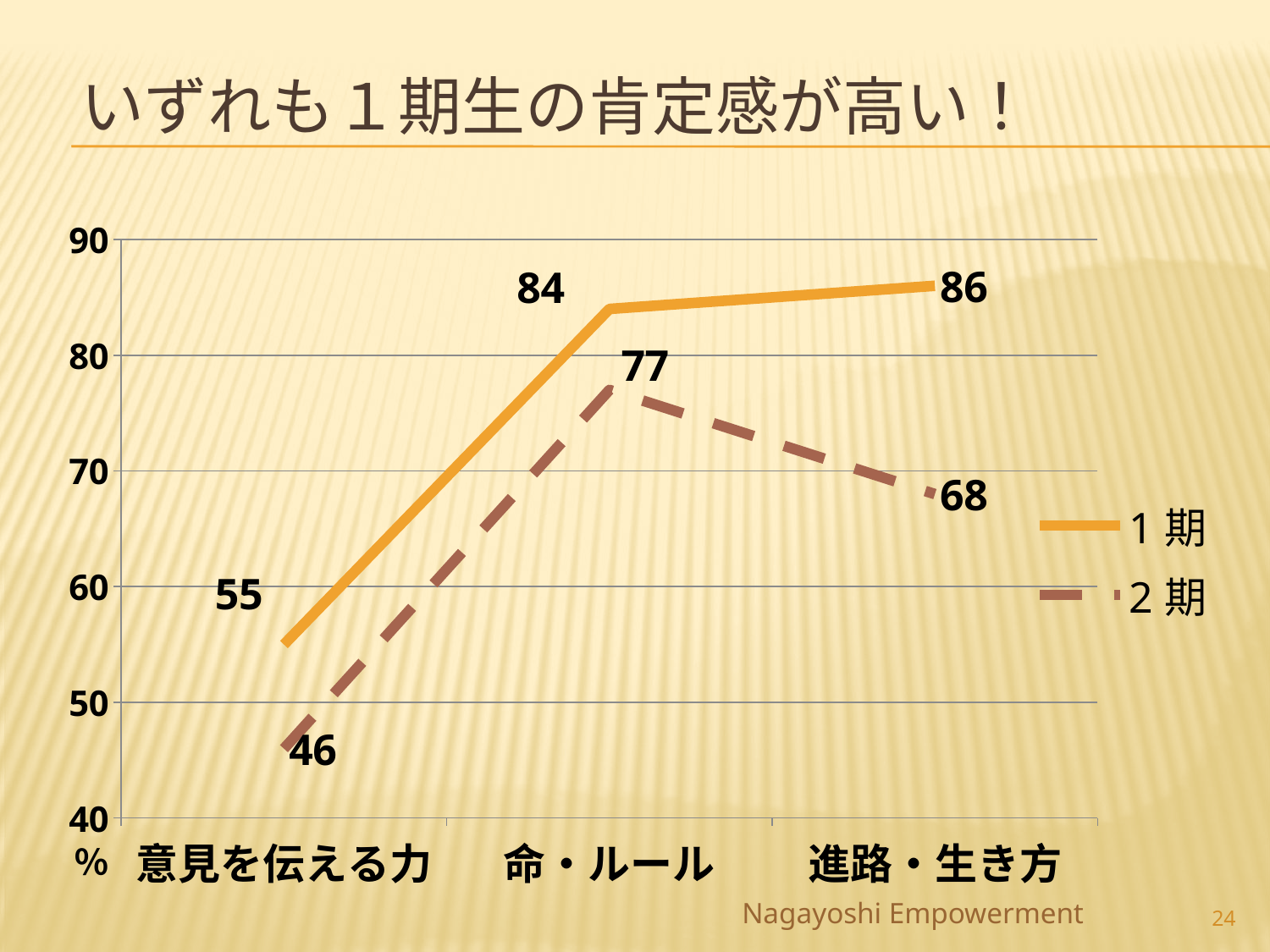
What is the value for 1期 at 意見を伝える力? 55 Which category has the highest value for 1期? 進路・生き方 Does the 2期 series rise or fall from 命・ルール to 進路・生き方? fall Which category has the lowest value for 2期? 意見を伝える力 How many categories are shown on the x axis? 3 What kind of chart is shown on the slide? line chart What is the value for 2期 at 命・ルール? 77 What is the difference between 1期 and 2期 at 意見を伝える力? 9 How many series does the legend list? 2 Which is larger at 命・ルール, 1期 or 2期? 1期 What is the value for 2期 at 進路・生き方? 68 What is the difference between 1期 and 2期 at 進路・生き方? 18